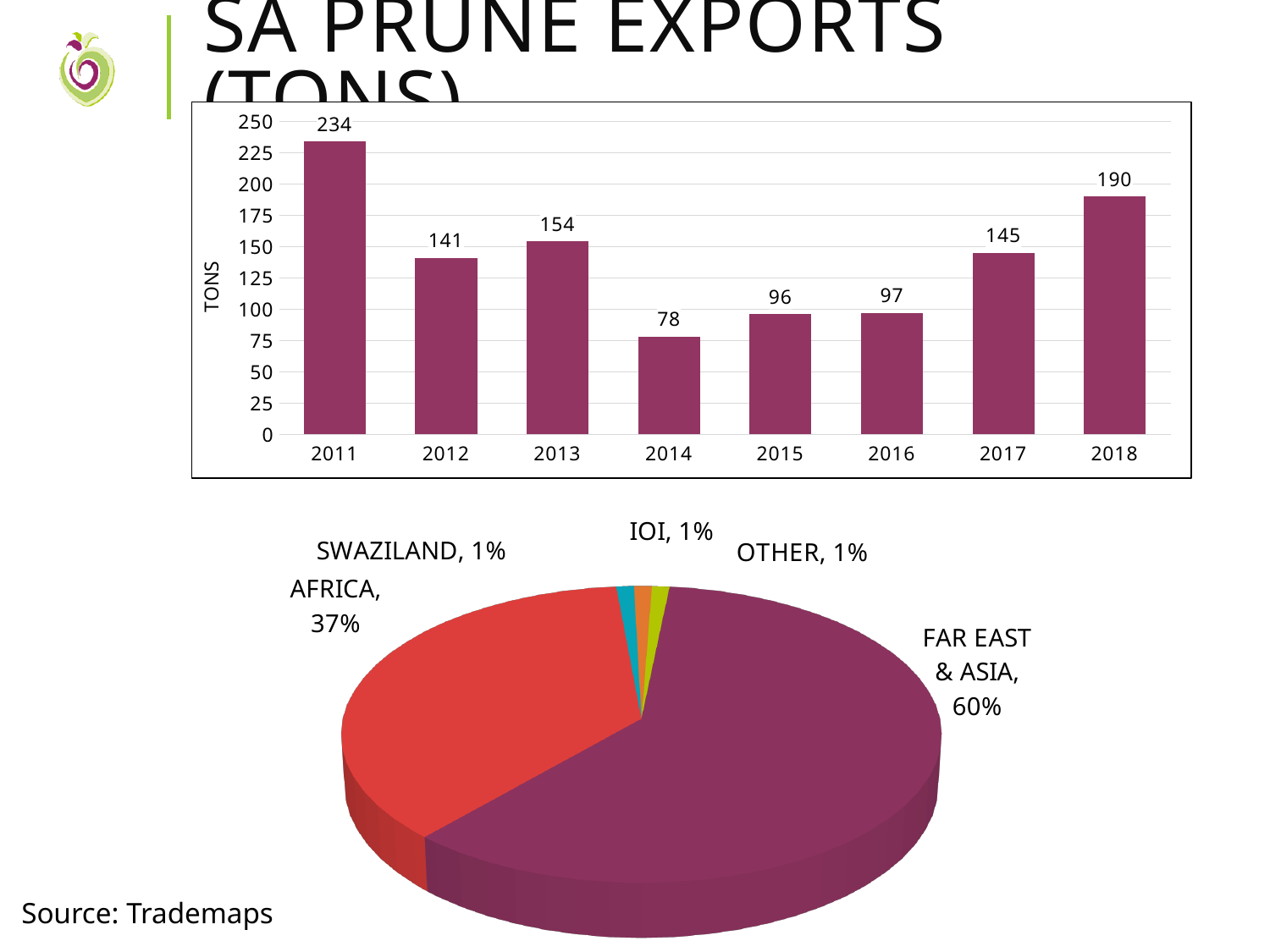
In the bar chart at the top of the slide, what was the value for 2018? 190 In the bar chart at the top of the slide, which is larger, the value for 2013 or the value for 2017? 2013 In the pie chart at the bottom of the slide, what share does FAR EAST & ASIA have? 60% In the bar chart at the top of the slide, what is the label on the vertical axis? TONS In the bar chart at the top of the slide, how many years are shown on the x axis? 8 In the pie chart at the bottom of the slide, what share does AFRICA have? 37% In the bar chart at the top of the slide, which year has the lowest value? 2014 In the bar chart at the top of the slide, which year has the highest value? 2011 In the bar chart at the top of the slide, what is the difference between the values for 2011 and 2012? 93 In the bar chart at the top of the slide, what was the value for 2014? 78 In the bar chart at the top of the slide, what was the value for 2011? 234 What kind of chart is shown at the top of the slide? Bar chart